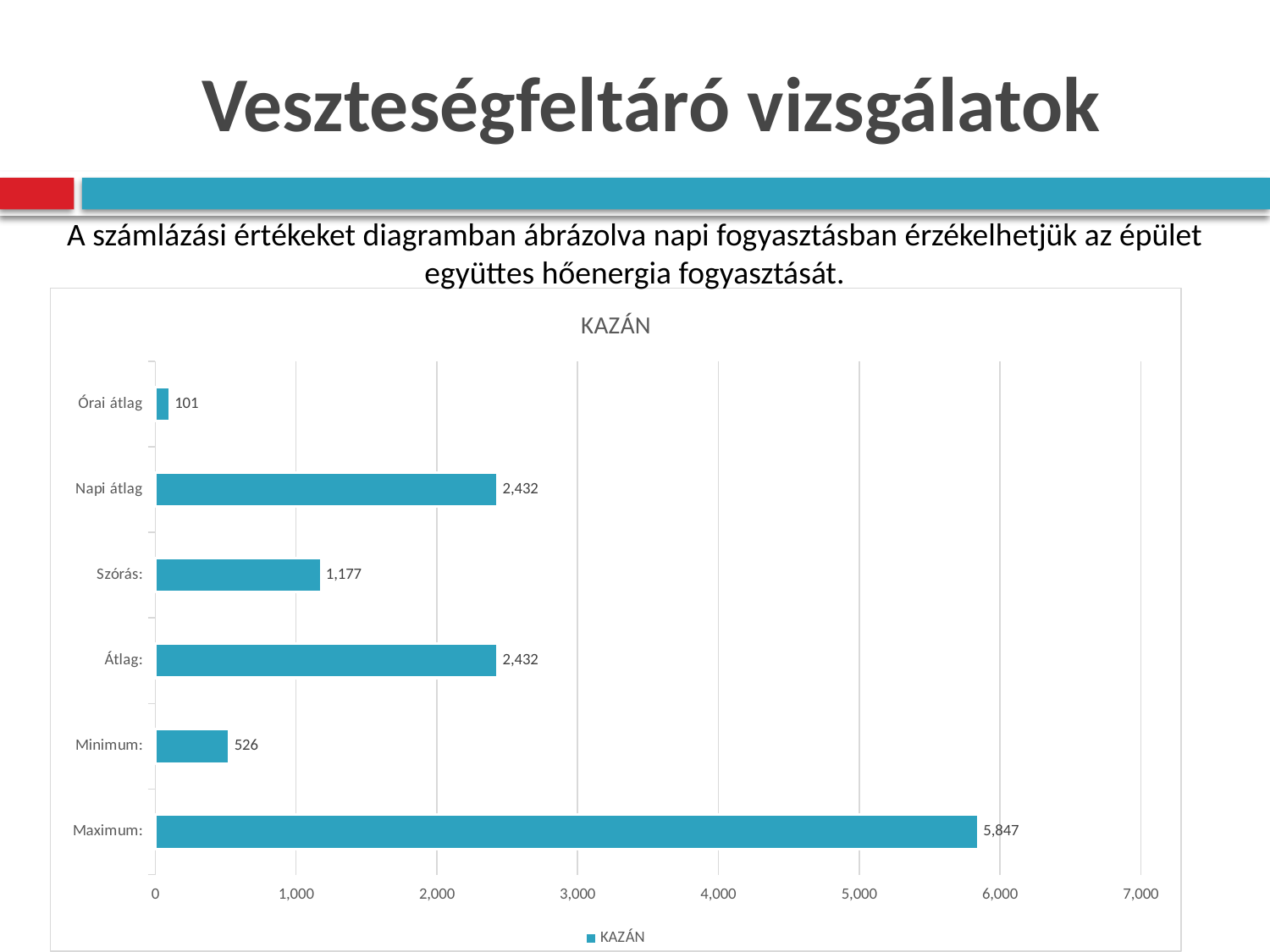
What is the difference between the Napi átlag and Szórás: values in the KAZÁN chart? 1,255 Which category has the lowest value in the KAZÁN chart? Órai átlag What kind of chart is the KAZÁN chart? Bar chart Which category has the highest value in the KAZÁN chart? Maximum: How many categories are shown in the KAZÁN chart? 6 What is the value for Szórás: in the KAZÁN chart? 1,177 What is the difference between the Maximum: and Minimum: values in the KAZÁN chart? 5,321 Which is larger in the KAZÁN chart, Szórás: or Minimum:? Szórás: What is the value for Maximum: in the KAZÁN chart? 5,847 How many series does the legend of the KAZÁN chart list? 1 What is the value for Órai átlag in the KAZÁN chart? 101 What is the value for Minimum: in the KAZÁN chart? 526